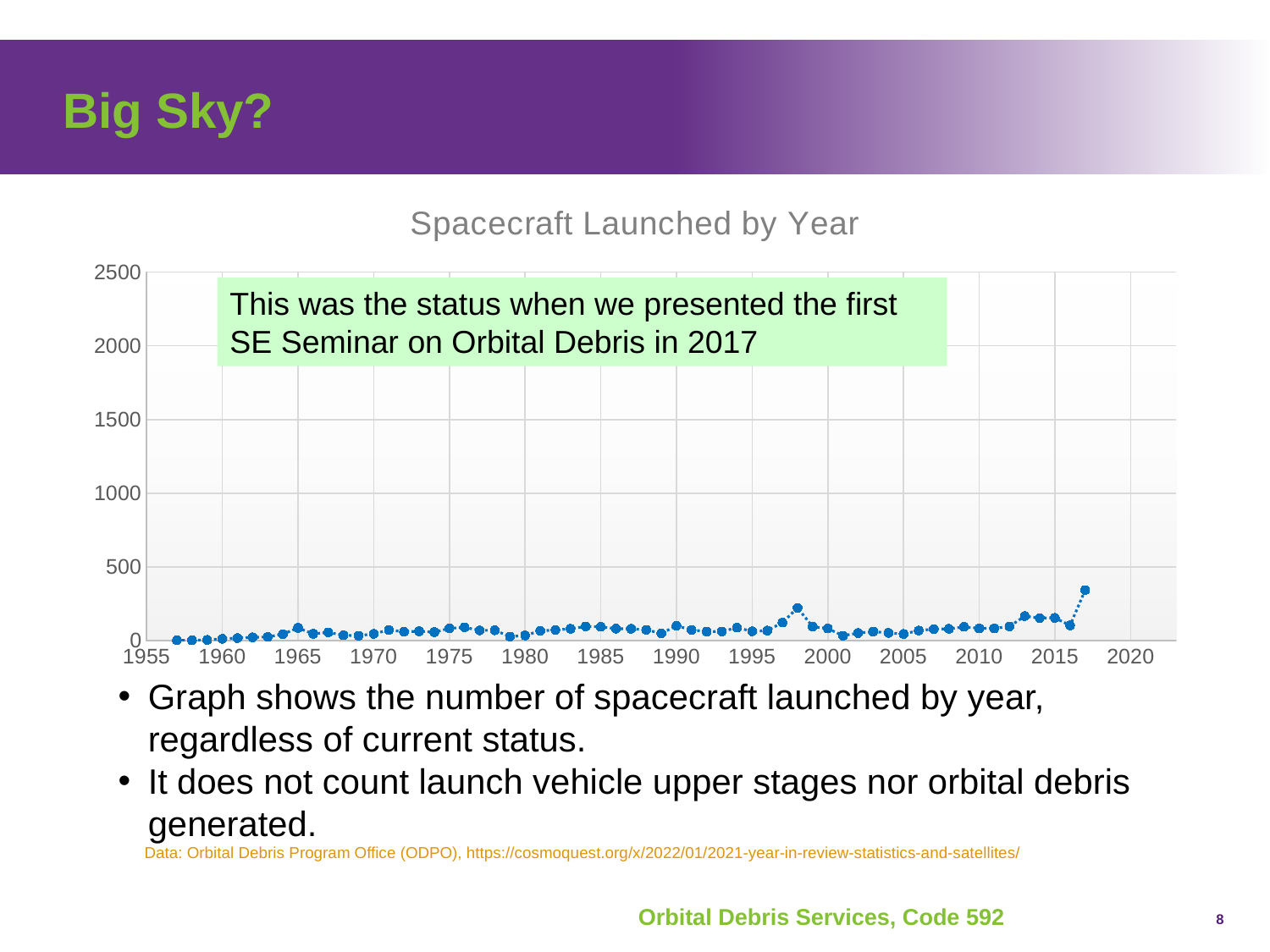
Is the value for 2017 greater or less than 1000? less What kind of chart is shown on the slide? Line chart Is the value for 2017 greater or less than 500? less Which year has the highest number of spacecraft launched in the chart? 2017 Is the value for 1998 greater or less than 500? less Which is larger, the value for 2017 or the value for 1998? 2017 What is the title of the chart? Spacecraft Launched by Year Which is larger, the value for 1998 or the value for 2005? 1998 According to the annotation on the chart, in what year was the first SE Seminar on Orbital Debris presented? 2017 Do the values rise or fall from 1998 to 2001? fall Do the values rise or fall from 2016 to 2017? rise